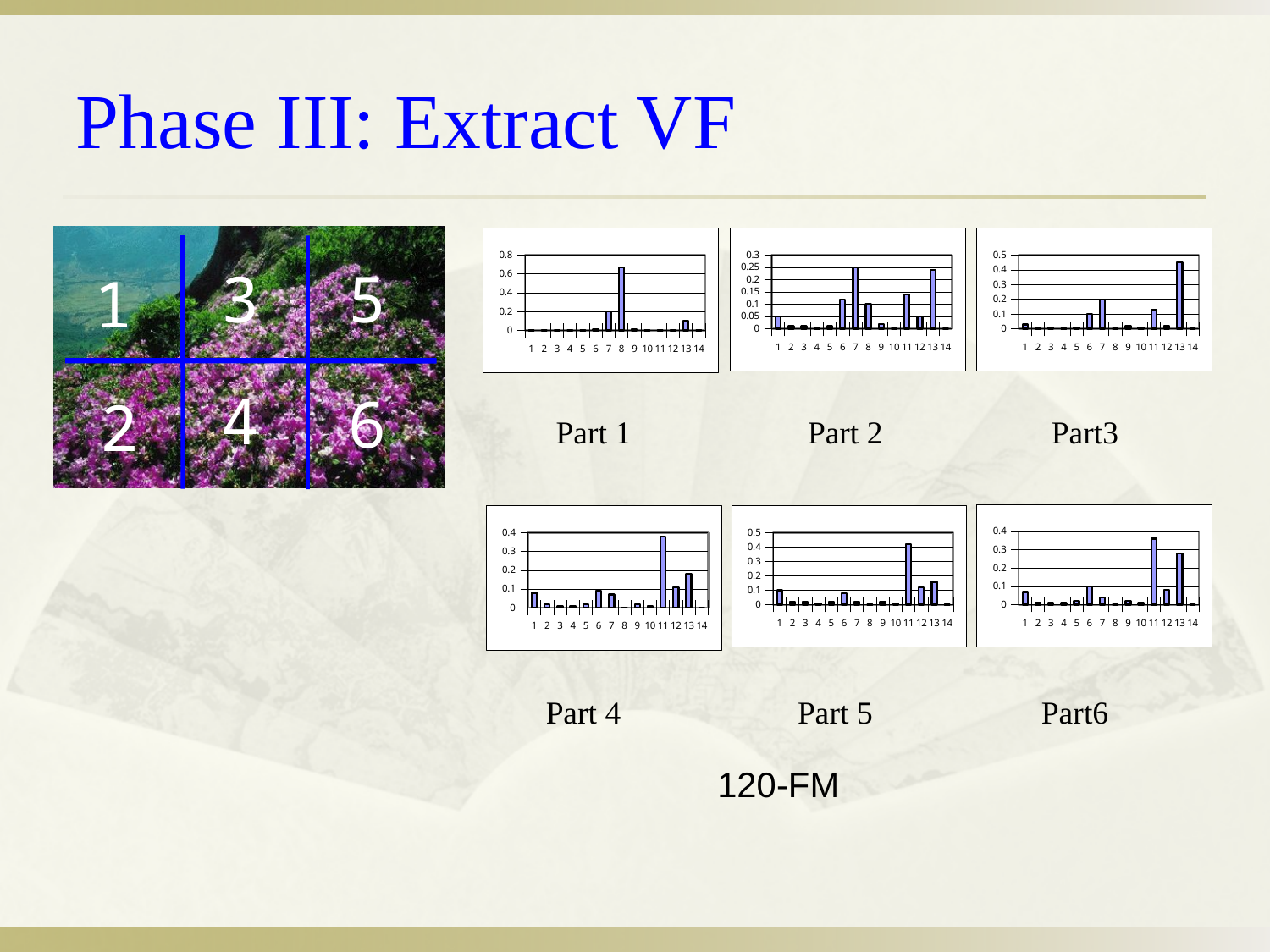
In the Part3 chart, is the value for category 13 greater or less than 0.4? greater In the Part6 chart, which is larger, the value for category 11 or the value for category 6? category 11 In the Part3 chart, which category has the highest bar? 13 How many bar charts are shown on the slide? 6 In the Part 4 chart, which category has the highest bar? 11 In the Part 1 chart, which category has the highest bar? 8 In the Part 2 chart, is the value for category 11 greater or less than 0.2? less In the Part 4 chart, which is larger, the value for category 11 or the value for category 13? category 11 What kind of chart is shown for Part 1? bar chart How many categories are plotted along the x axis of the Part 4 chart? 14 In the Part 1 chart, is the value for category 8 greater or less than 0.6? greater